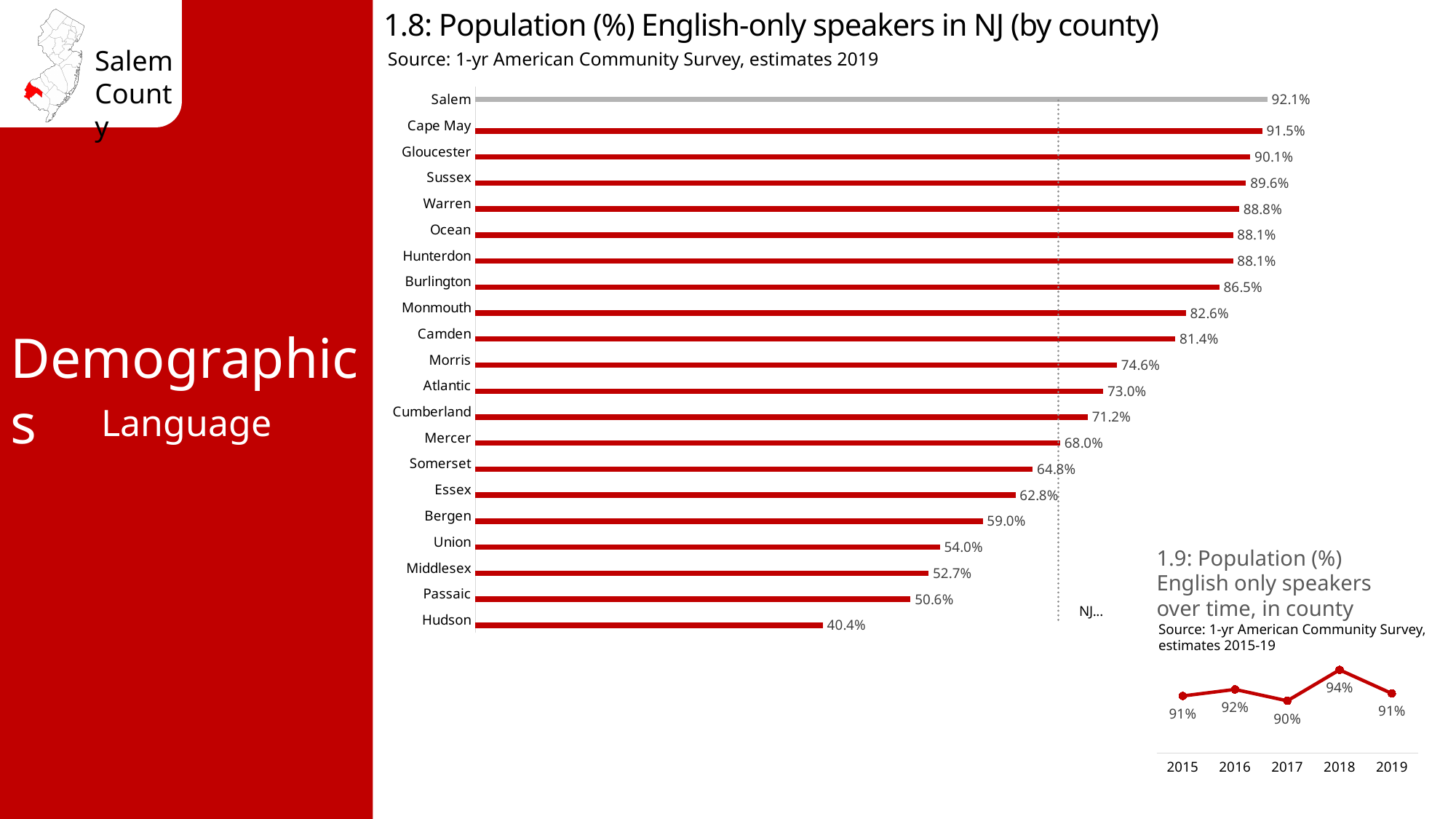
In chart 1.8, what is the difference between the values for Salem and Hudson? 51.7% In chart 1.9, which year has the lowest value? 2017 In chart 1.8, what is the value for Salem? 92.1% In chart 1.8, which has a larger value, Morris or Atlantic? Morris In chart 1.8, which county has the highest percentage of English-only speakers? Salem What kind of chart is chart 1.9? Line chart In chart 1.8, what is the value for Hudson? 40.4% In chart 1.8, how many counties are plotted? 21 In chart 1.9, what is the value for 2018? 94% In chart 1.8, which county has the lowest percentage of English-only speakers? Hudson What kind of chart is chart 1.8? Bar chart In chart 1.9, how many years are plotted? 5